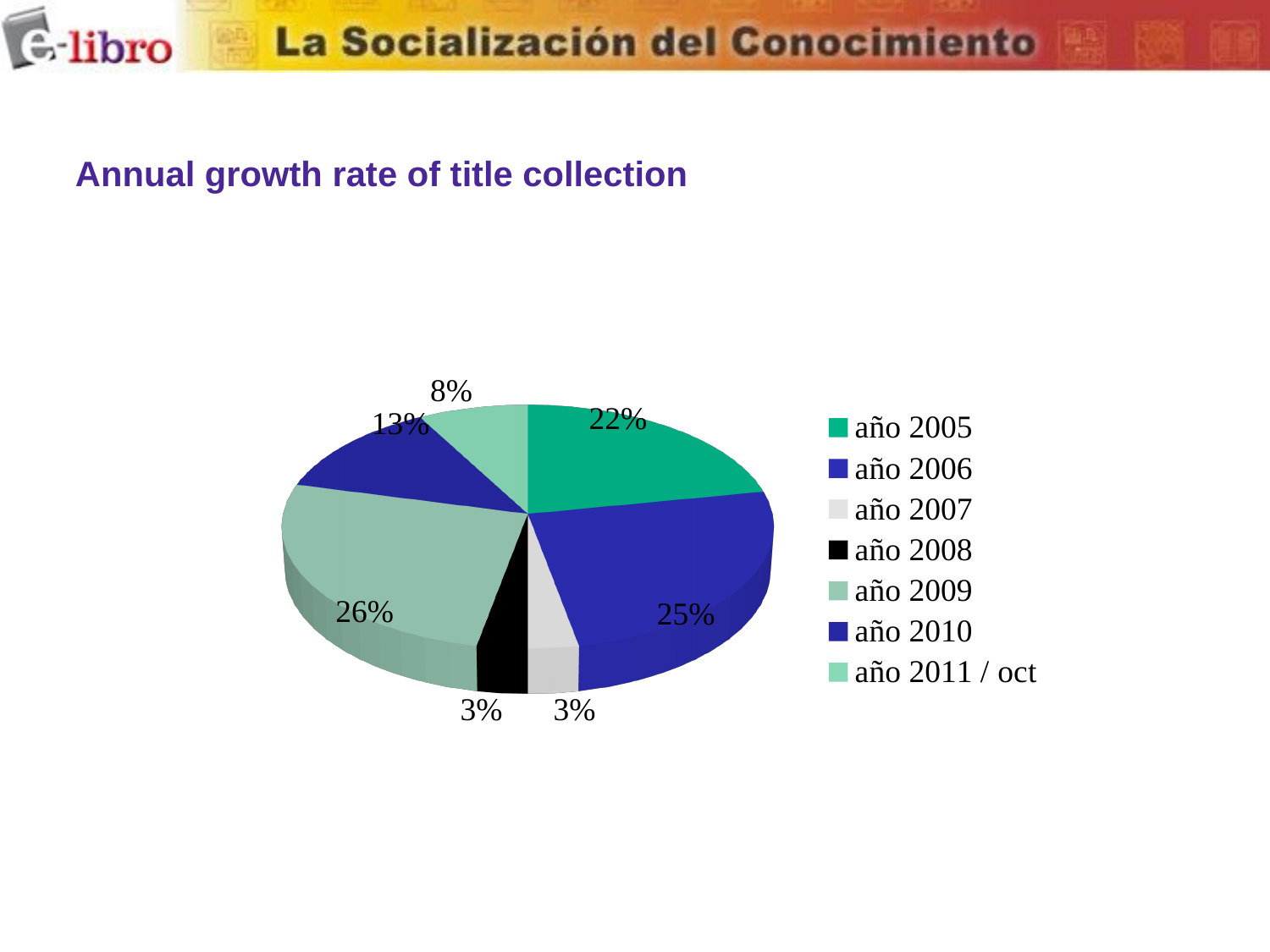
What is the title of the chart on the slide? Annual growth rate of title collection What share of the pie does año 2005 represent? 22% What type of chart is shown on the slide? pie chart Which year has the largest slice of the pie? año 2009 What share of the pie does año 2011 / oct represent? 8% How many slices does the pie chart have? 7 What share of the pie does año 2010 represent? 13% Which is larger, the share for año 2005 or the share for año 2011 / oct? año 2005 What share of the pie does año 2009 represent? 26% What share of the pie does año 2006 represent? 25% What is the difference between the shares for año 2006 and año 2010? 12% What is the combined share of año 2007 and año 2008? 6%